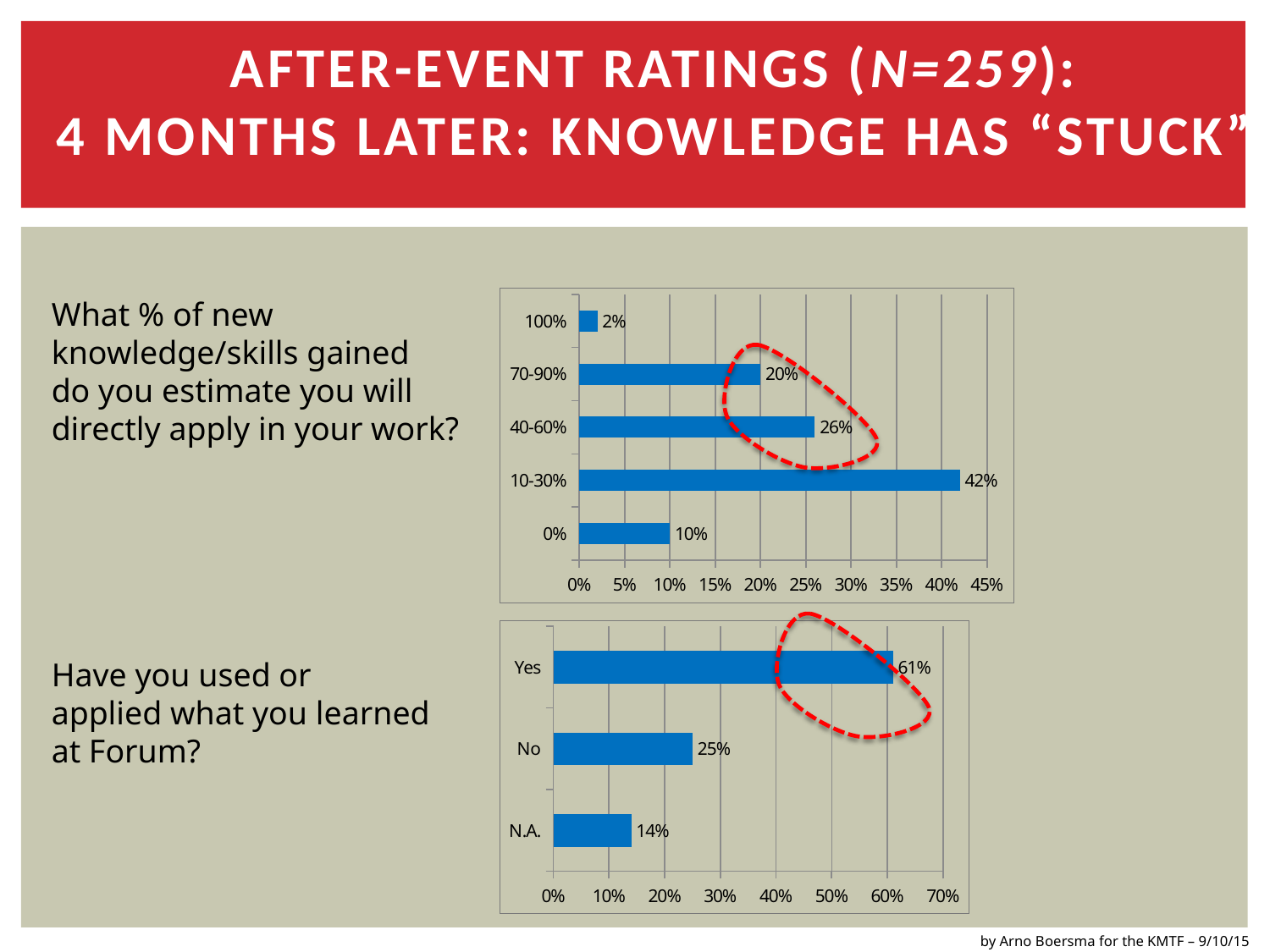
In the top chart, what is the value for the 70-90% category? 20% In the top chart, how many categories are shown? 5 In the bottom chart, what is the difference between the values for Yes and No? 36% In the top chart (What % of new knowledge/skills gained do you estimate you will directly apply in your work?), what is the value for the 10-30% category? 42% In the bottom chart (Have you used or applied what you learned at Forum?), what is the value for Yes? 61% What kind of chart is the bottom chart? bar chart In the bottom chart, what is the value for N.A.? 14% In the bottom chart, how many categories are shown? 3 In the top chart, what is the difference between the values for 40-60% and 70-90%? 6% In the top chart, which category has the highest value? 10-30% In the top chart, which category has the lowest value? 100% In the top chart, is the value for 0% larger or smaller than the value for 40-60%? smaller